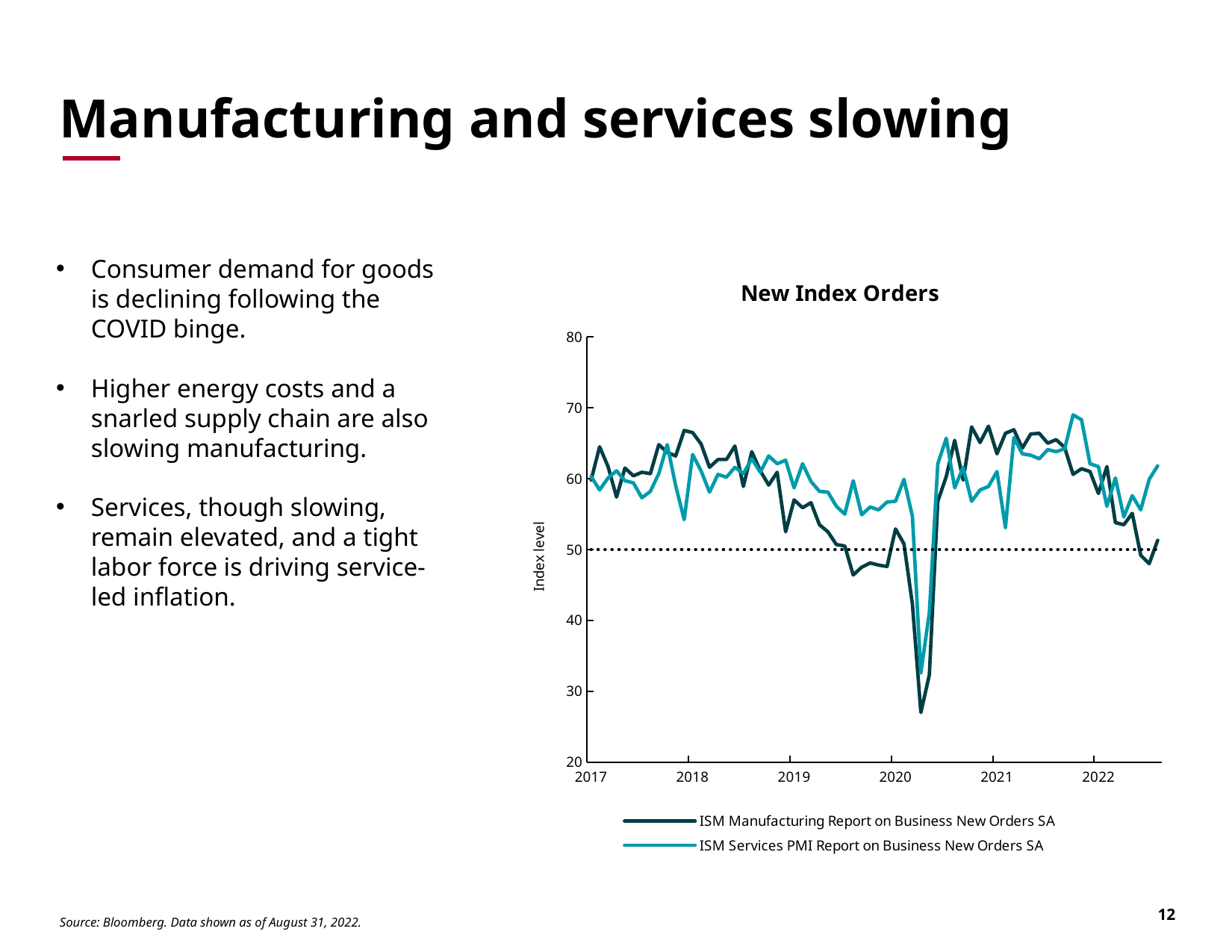
Does the ISM Manufacturing Report on Business New Orders SA series rise or fall between the start of 2019 and the end of 2019? fall What is the title of the chart? New Index Orders Is the lowest value of the ISM Services PMI Report on Business New Orders SA series, reached in 2020, greater or less than 30? greater What kind of chart is shown on the slide? line chart Does the ISM Manufacturing Report on Business New Orders SA series rise or fall from the start of 2021 to the end of the chart in 2022? fall Is the value of the ISM Manufacturing Report on Business New Orders SA series at the start of 2017 greater or less than 50? greater Is the lowest value of the ISM Manufacturing Report on Business New Orders SA series, reached in 2020, greater or less than 30? less What is the label on the y axis of the chart? Index level How many series does the legend list? 2 At the 2020 trough, which series falls lower: ISM Manufacturing or ISM Services? ISM Manufacturing Report on Business New Orders SA